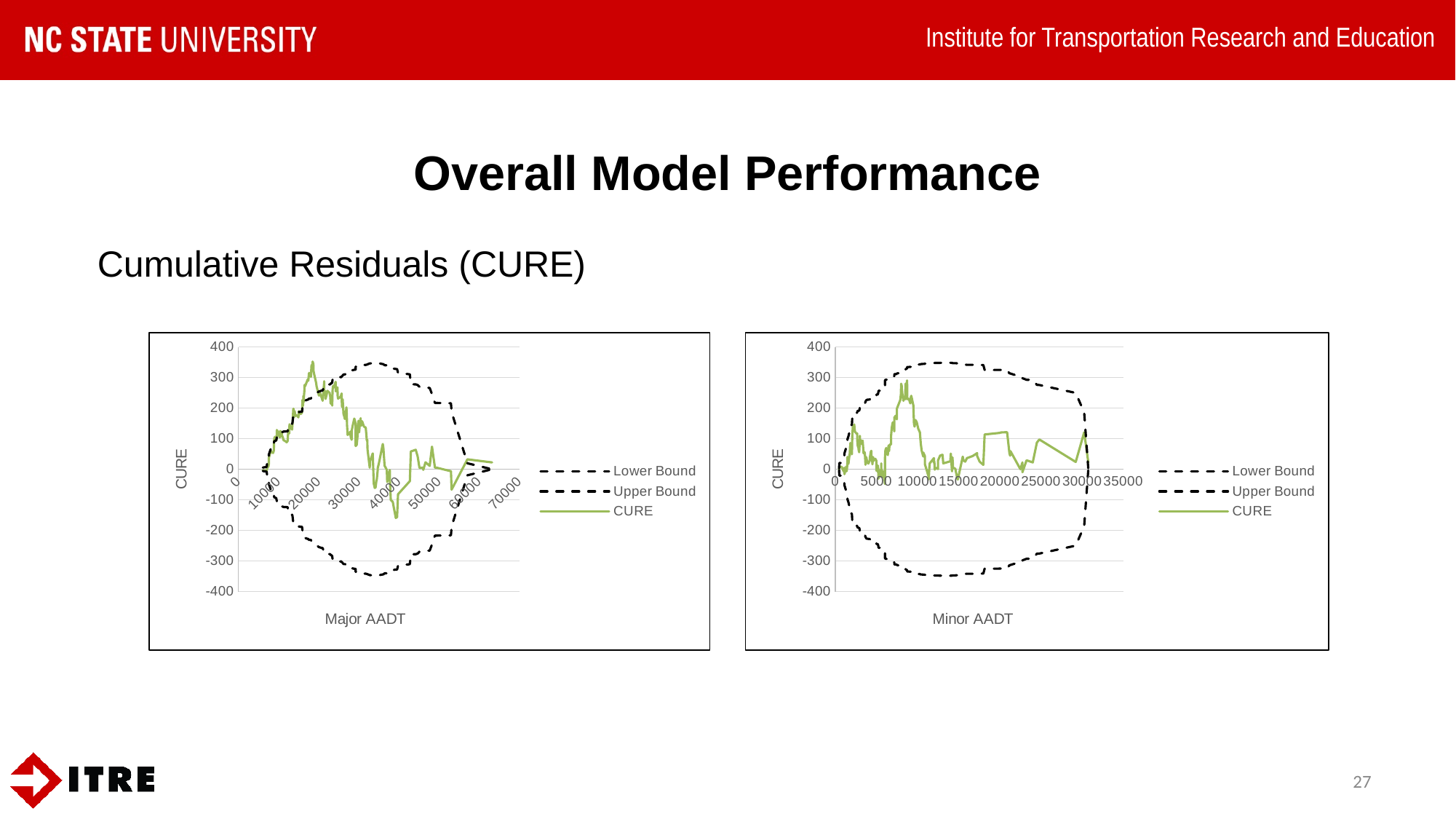
In the left chart (Major AADT), is the CURE value at 20000 greater or less than 200? greater In the right chart (Minor AADT), is the CURE value at 25000 greater or less than 200? less What is the x-axis title of the right chart? Minor AADT What kind of chart is the left chart (Major AADT)? line chart What kind of chart is the right chart (Minor AADT)? line chart In the left chart (Major AADT), is the Lower Bound value at 40000 greater or less than -300? less How many series does the legend of the right chart (Minor AADT) list? 3 How many series does the legend of the left chart (Major AADT) list? 3 Which series in the left chart (Major AADT) is drawn as a solid green line? CURE